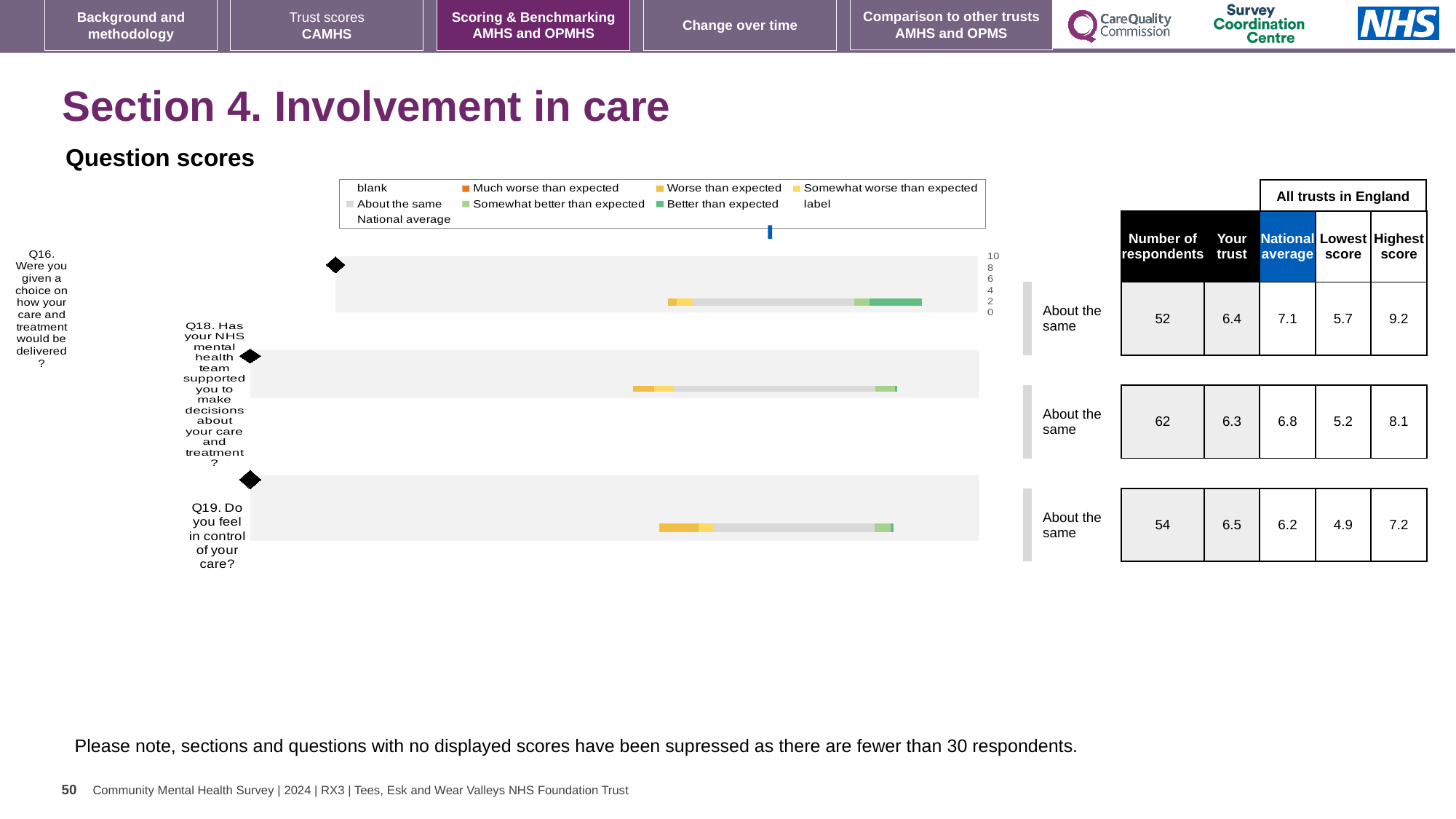
How many questions are plotted in the question scores chart? 3 By how much does the 'Your trust' score for Q19 exceed the national average? 0.3 For Q18, which is larger: the 'Your trust' score or the national average? National average What is the national average score for Q19 (Do you feel in control of your care?)? 6.2 What benchmark category is shown for all three questions in the chart? About the same What is the difference between the highest score and the lowest score for Q16? 3.5 What kind of chart is used to show the question scores on this slide? bar chart Which question has the highest 'Your trust' score? Q19 What is the 'Your trust' score for Q16 (Were you given a choice on how your care and treatment would be delivered?)? 6.4 What is the lowest score across all trusts in England for Q19? 4.9 How many respondents answered Q18 (Has your NHS mental health team supported you to make decisions about your care and treatment?)? 62 What is the maximum value shown on the chart's score axis? 10